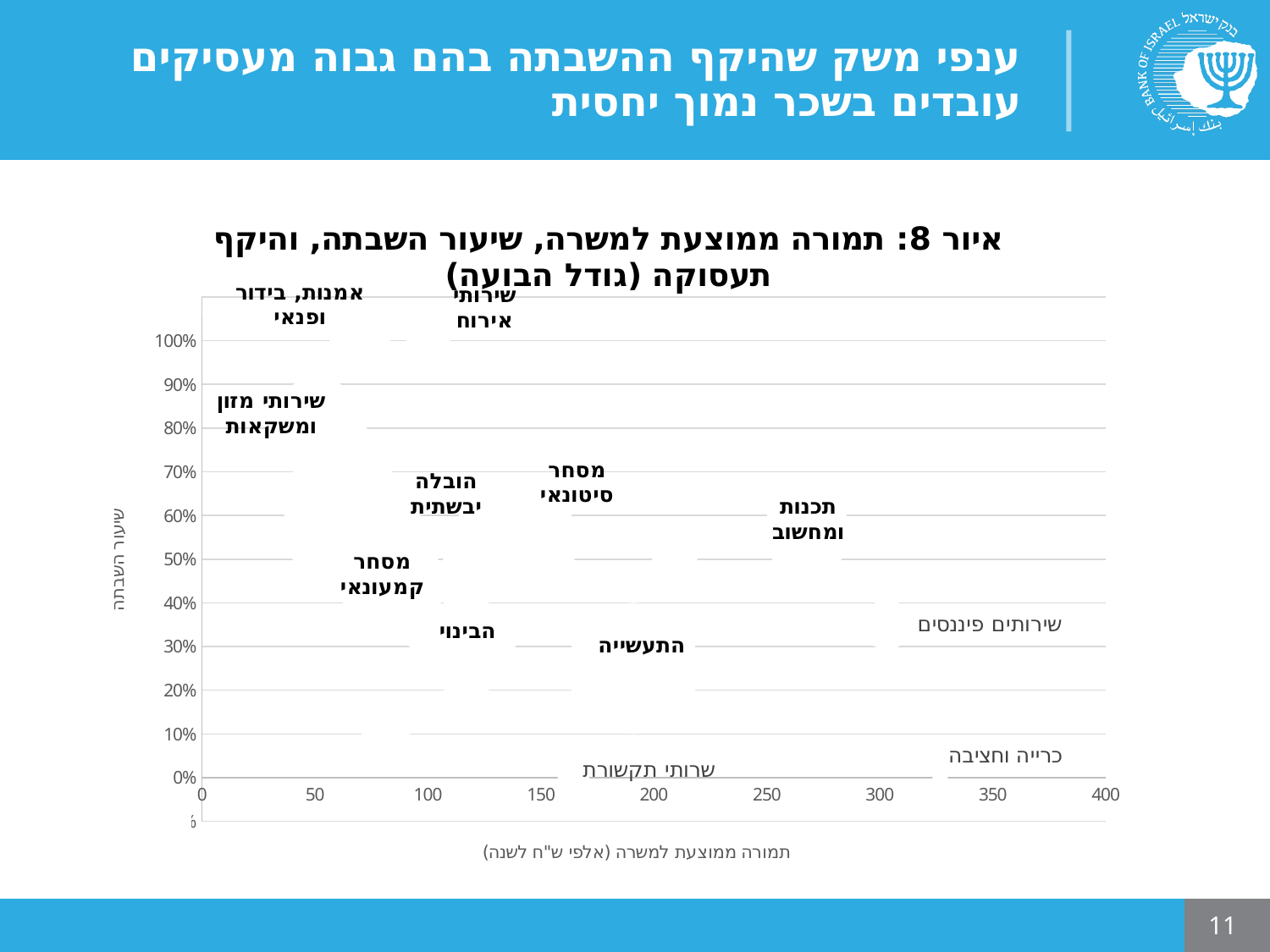
What is the title of the chart on the slide? איור 8: תמורה ממוצעת למשרה, שיעור השבתה, והיקף תעסוקה (גודל הבועה) Which industry has a higher shutdown rate, אמנות, בידור ופנאי or כרייה וחציבה? אמנות, בידור ופנאי Which industry has a higher average compensation per job, שירותים פיננסים or שירותי מזון ומשקאות? שירותים פיננסים Is the shutdown rate for שירותי מזון ומשקאות greater or less than 50%? greater How many industries are labelled on the chart? 12 Is the shutdown rate for כרייה וחציבה greater or less than 50%? less Is the shutdown rate (שיעור השבתה) for שירותים פיננסים greater or less than 60%? less What is the highest value shown on the horizontal axis of the chart? 400 What is the label of the horizontal axis of the chart? תמורה ממוצעת למשרה (אלפי ש"ח לשנה) What kind of chart is shown on the slide? Bubble (scatter) chart What is the highest value shown on the vertical axis of the chart? 100%